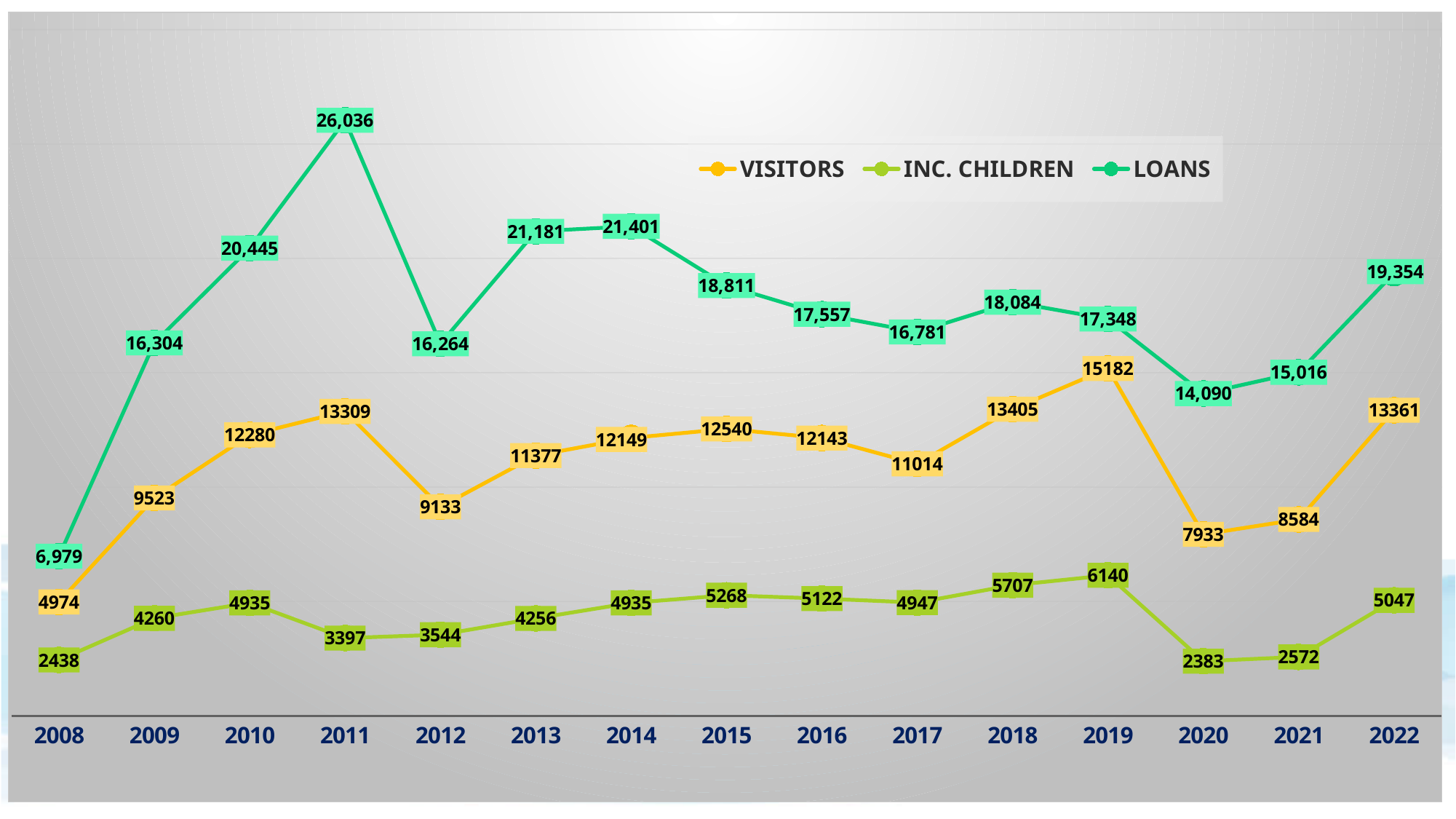
Which is larger, the VISITORS value for 2010 or for 2012? 2010 What is the difference between the VISITORS values for 2022 and 2021? 4777 In which year is the INC. CHILDREN series at its highest? 2019 What is the INC. CHILDREN value for 2020? 2383 What is the LOANS value for 2011? 26,036 In which year is the LOANS series at its highest? 2011 How many years are plotted along the x axis? 15 In which year is the VISITORS series at its lowest? 2008 What is the VISITORS value for 2019? 15182 Does the LOANS series rise or fall from 2019 to 2020? fall How many series does the legend list? 3 What kind of chart is shown on the slide? line chart